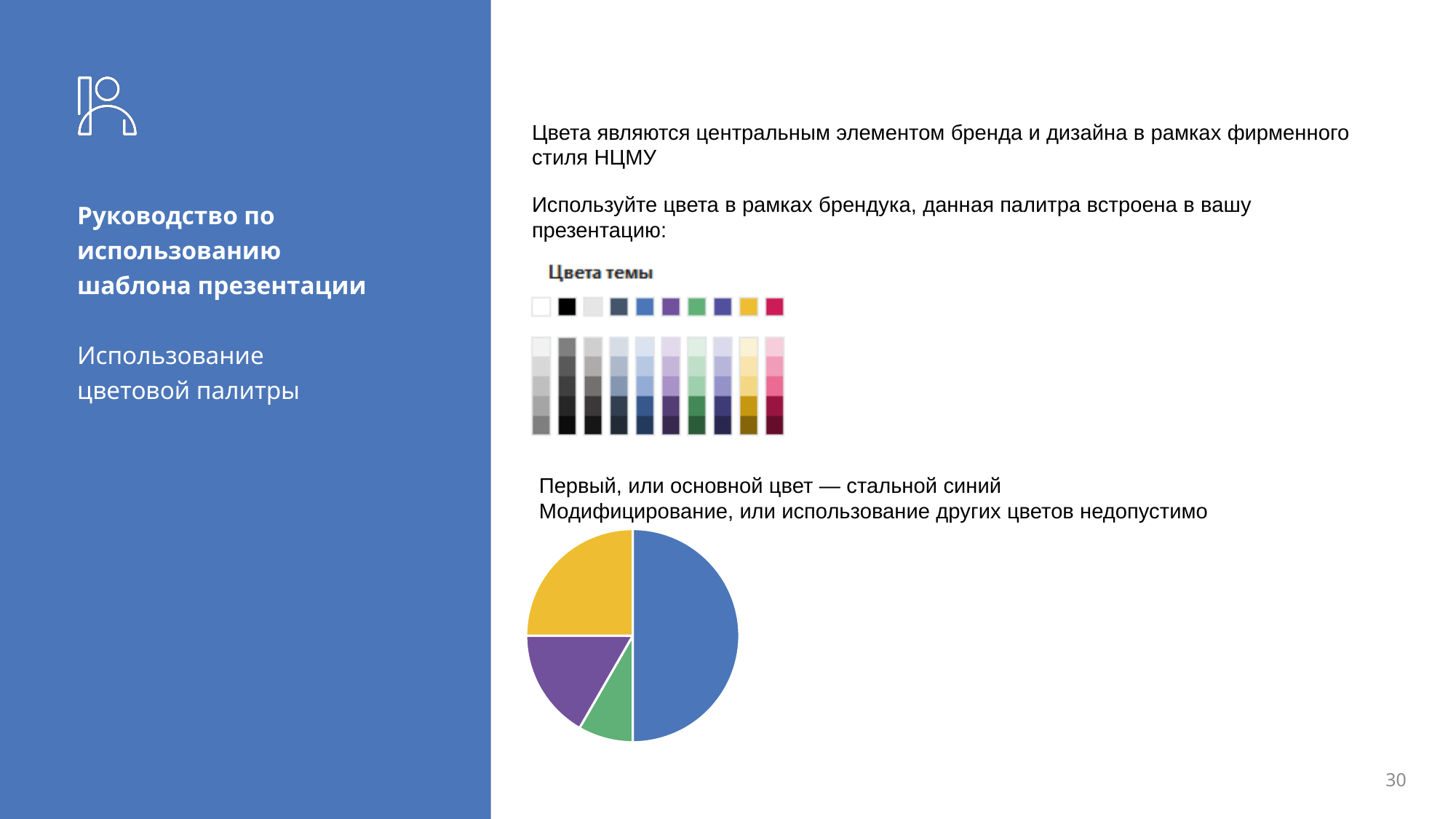
Does the pie chart show any data labels? No Which colour slice is the largest in the pie chart? blue Does the pie chart have a legend? No What kind of chart is shown on the slide? pie chart How many slices does the pie chart have? 4 In the pie chart, which slice is larger, the purple one or the green one? purple Which colour slice is the smallest in the pie chart? green In the pie chart, which slice is larger, the blue one or the yellow one? blue